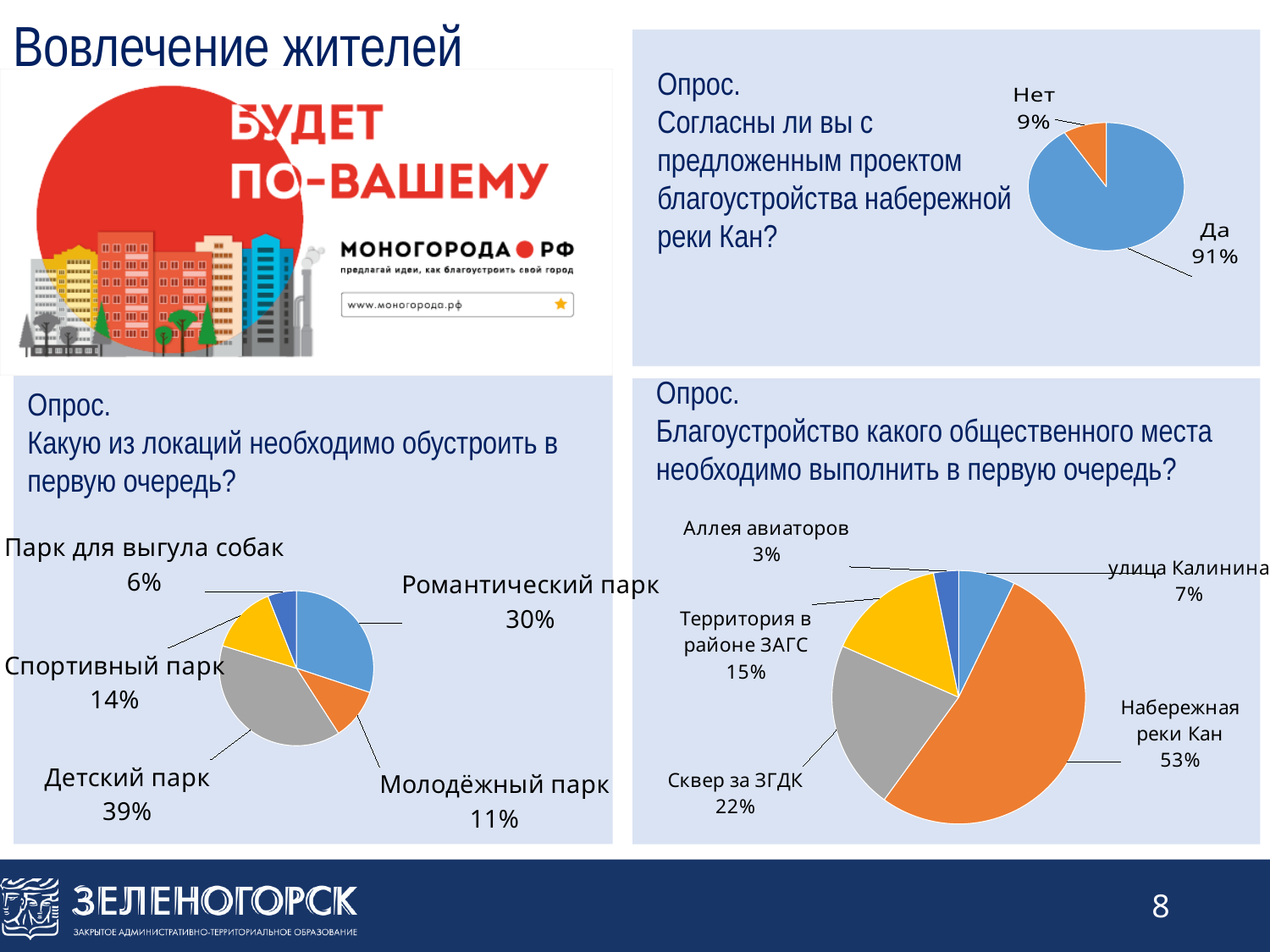
In the bottom-left pie chart "Какую из локаций необходимо обустроить в первую очередь?", how many locations are shown? 5 In the top-right pie chart about the Kan river embankment project, what share answered "Нет"? 9% In the bottom-right pie chart "Благоустройство какого общественного места необходимо выполнить в первую очередь?", what share is shown for Набережная реки Кан? 53% In the top-right pie chart about the Kan river embankment project, how many slices does the pie have? 2 In the bottom-left pie chart "Какую из локаций необходимо обустроить в первую очередь?", what share is shown for Детский парк? 39% In the bottom-right pie chart "Благоустройство какого общественного места необходимо выполнить в первую очередь?", which is larger: Сквер за ЗГДК or Территория в районе ЗАГС? Сквер за ЗГДК What type of chart is used for the bottom-right survey "Благоустройство какого общественного места необходимо выполнить в первую очередь?"? Pie chart In the bottom-right pie chart "Благоустройство какого общественного места необходимо выполнить в первую очередь?", which place has the smallest share? Аллея авиаторов In the bottom-left pie chart "Какую из локаций необходимо обустроить в первую очередь?", what is the difference between the shares of Романтический парк and Молодёжный парк? 19% In the top-right pie chart about the Kan river embankment project, what share of respondents answered "Да"? 91% In the bottom-left pie chart "Какую из локаций необходимо обустроить в первую очередь?", which location has the largest share? Детский парк In the bottom-left pie chart "Какую из локаций необходимо обустроить в первую очередь?", which location has the smallest share? Парк для выгула собак